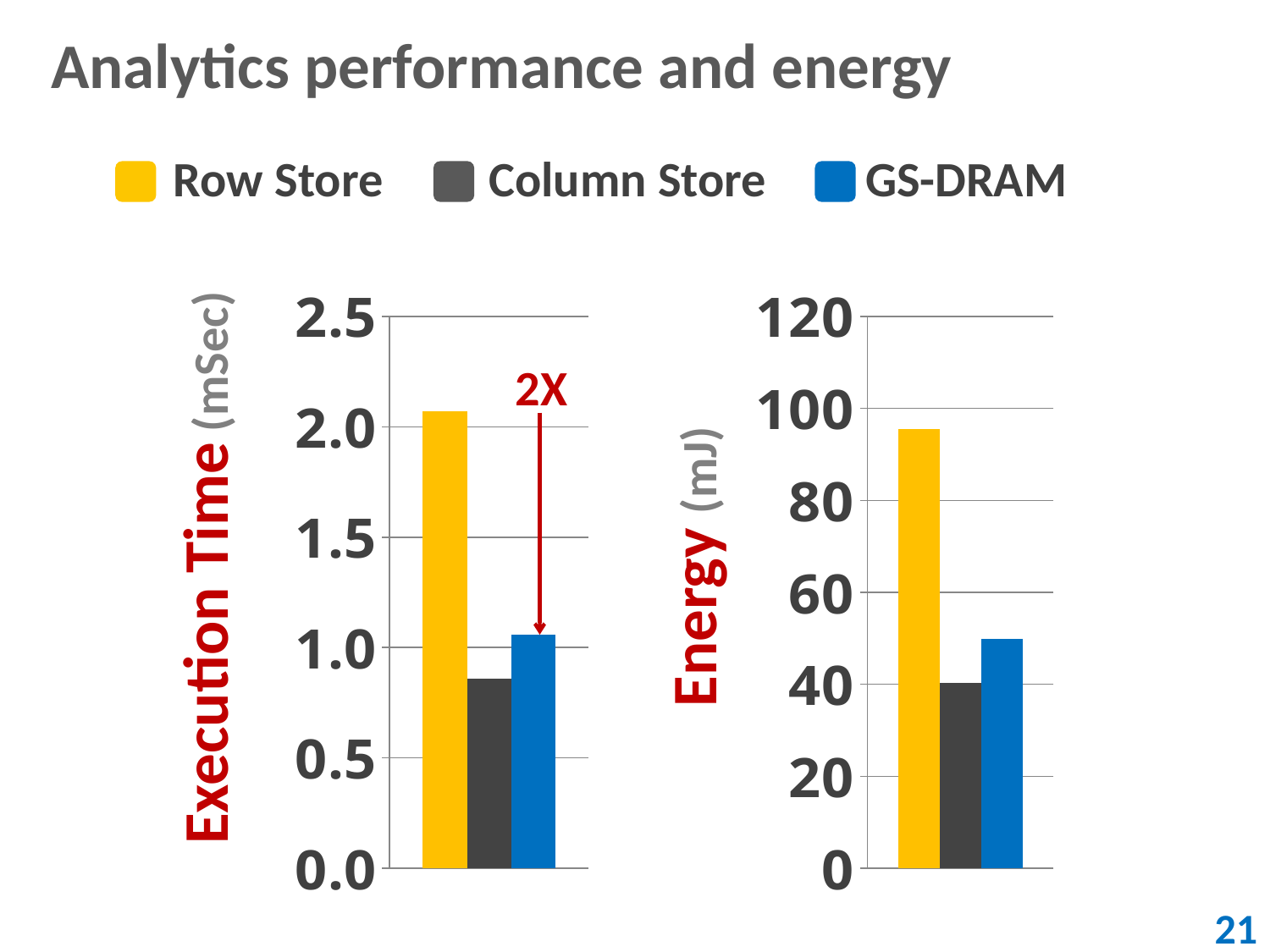
In the Energy chart, is the value for Row Store greater or less than 80? greater What annotation is written above the GS-DRAM bar in the Execution Time chart? 2X In the Energy chart, which series has the lowest value? Column Store In the Execution Time chart, which is larger, the value for GS-DRAM or the value for Column Store? GS-DRAM In the Execution Time chart, is the value for Column Store greater or less than 1.0? less In the Execution Time chart, is the value for Row Store greater or less than 1.5? greater What kind of chart is the Execution Time chart on the left? bar chart In the Execution Time chart, which series has the highest value? Row Store How many series does the legend list? 3 In the Execution Time chart, which series has the lowest value? Column Store In the Energy chart, which series has the highest value? Row Store